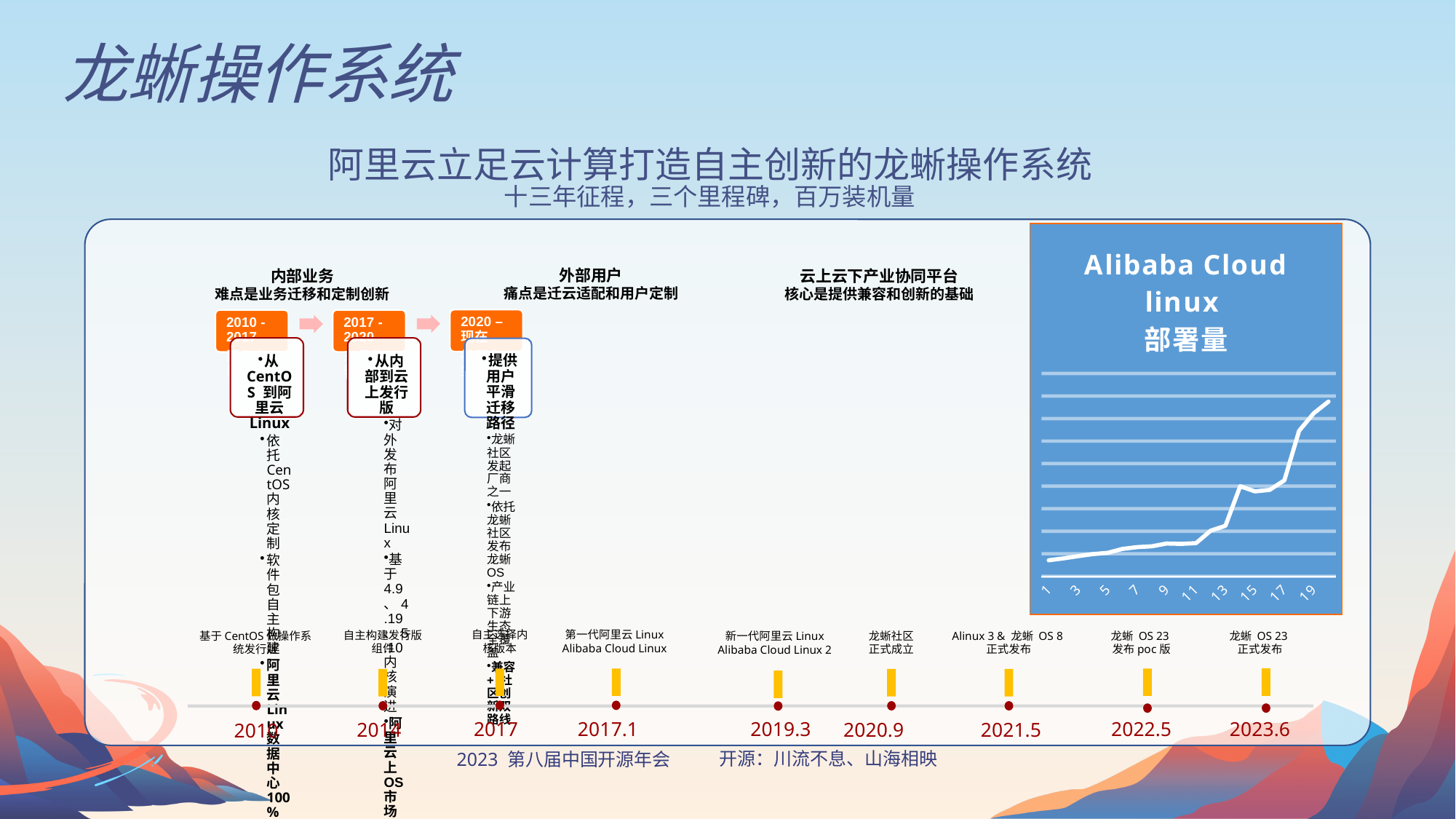
In the Alibaba Cloud linux 部署量 chart, do the values generally rise or fall from left to right along the x axis? rise What kind of chart is shown in the blue panel on the right of the slide? line chart In the Alibaba Cloud linux 部署量 chart, is the lowest point of the line at the left end or the right end of the x axis? left end How many tick labels are printed on the x axis of the Alibaba Cloud linux 部署量 chart? 10 What is the first tick label on the x axis of the Alibaba Cloud linux 部署量 chart? 1 In the Alibaba Cloud linux 部署量 chart, is the value at x = 13 larger or smaller than the value at x = 3? larger In the Alibaba Cloud linux 部署量 chart, is the value at x = 19 larger or smaller than the value at x = 1? larger What is the last tick label on the x axis of the Alibaba Cloud linux 部署量 chart? 19 How many lines are plotted in the Alibaba Cloud linux 部署量 chart? 1 What is the title of the chart in the blue panel on the right? Alibaba Cloud linux 部署量 In the Alibaba Cloud linux 部署量 chart, is the highest point of the line at the left end or the right end of the x axis? right end